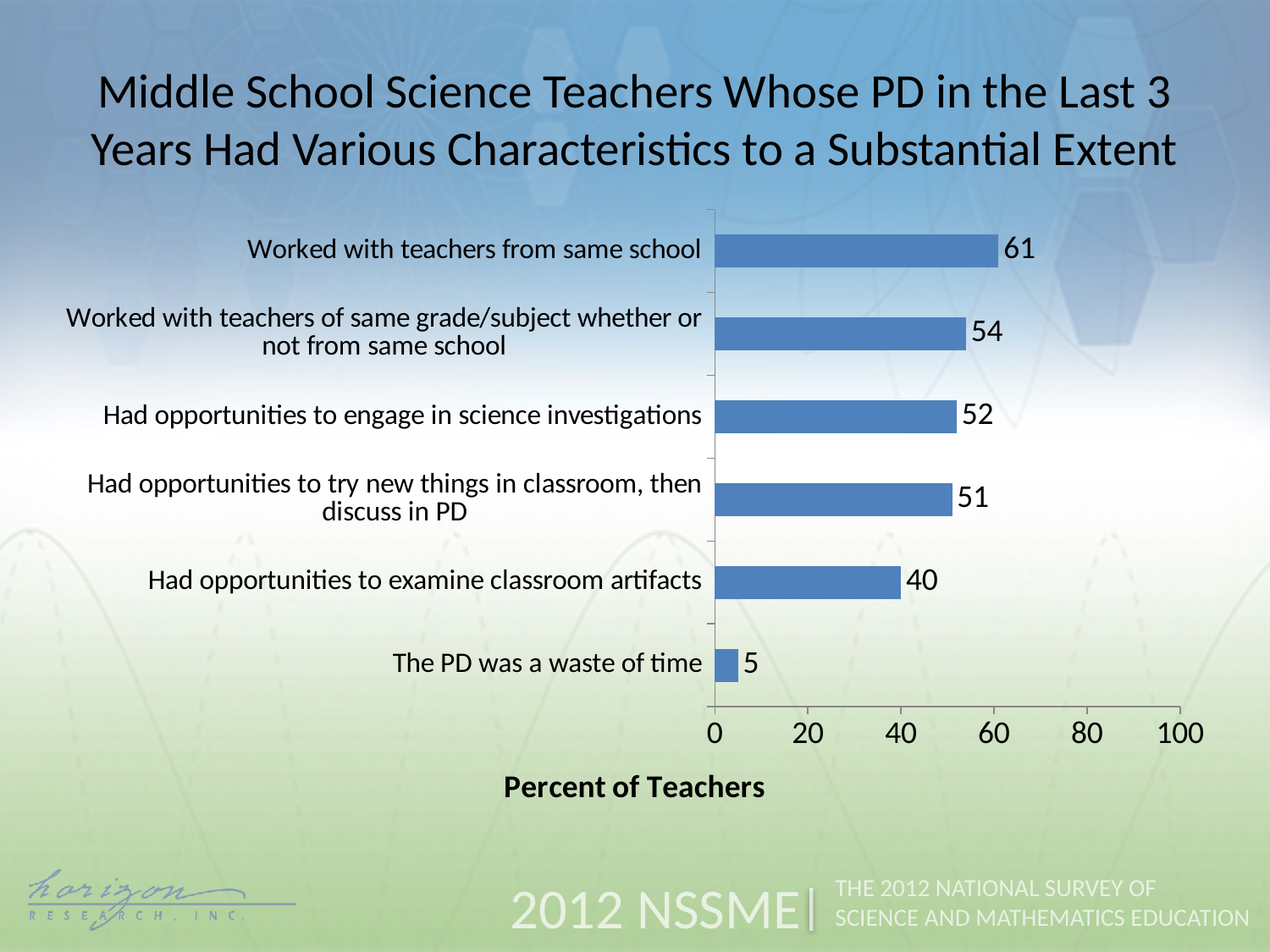
What is the value for "Had opportunities to engage in science investigations"? 52 Is the value for "Had opportunities to try new things in classroom, then discuss in PD" greater or less than 40? greater What is the value for "Had opportunities to examine classroom artifacts"? 40 Which is larger: the value for "Worked with teachers of same grade/subject whether or not from same school" or the value for "Had opportunities to examine classroom artifacts"? Worked with teachers of same grade/subject whether or not from same school Which category has the lowest value? The PD was a waste of time What kind of chart is shown on the slide? Bar chart What is the difference between the values for "Worked with teachers from same school" and "Had opportunities to examine classroom artifacts"? 21 What percent of teachers reported that the PD was a waste of time? 5 What percent of teachers worked with teachers from the same school? 61 Which category has the highest value? Worked with teachers from same school What is the label of the horizontal axis? Percent of Teachers How many categories are shown in the chart? 6